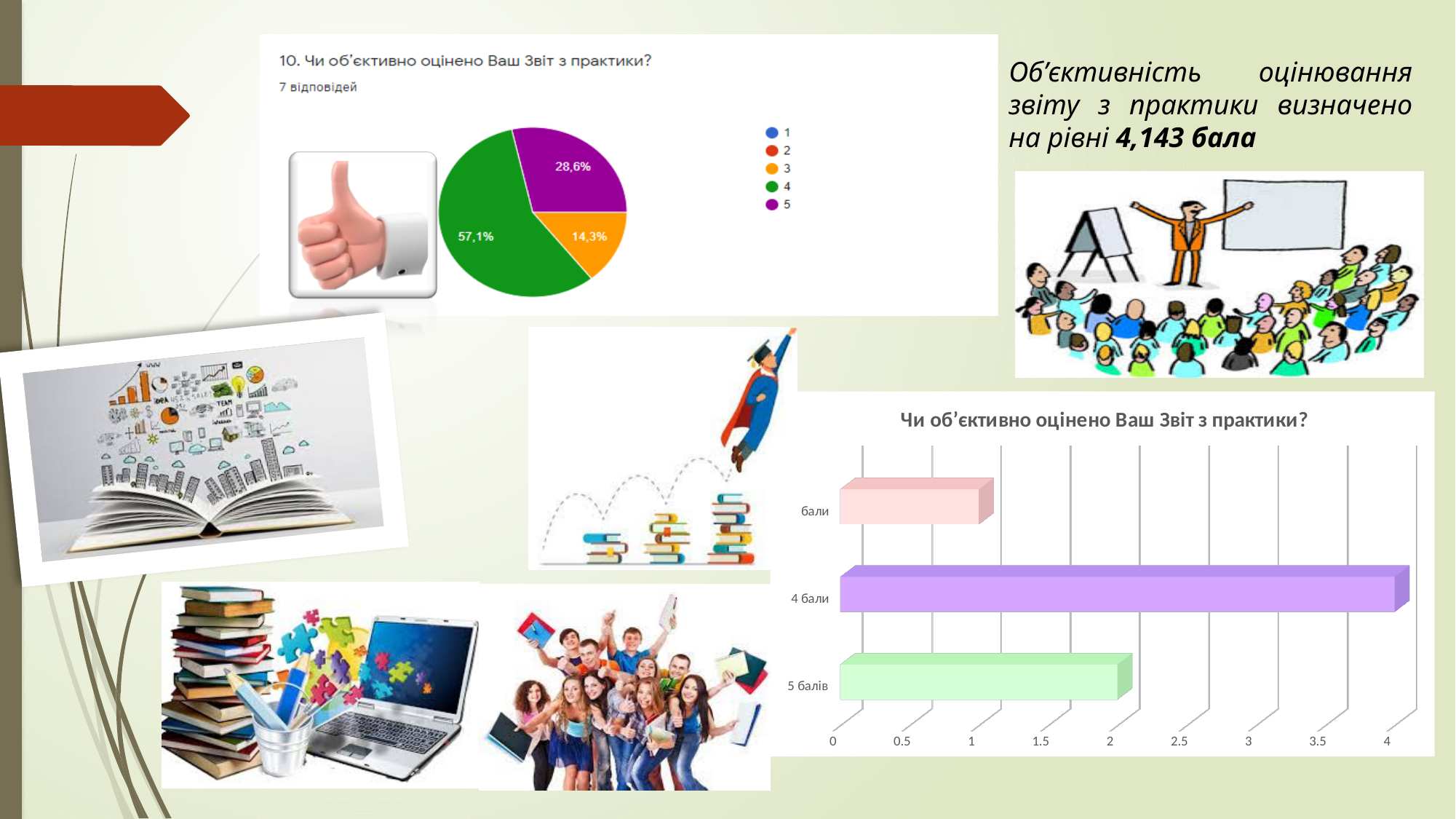
On the pie chart at the top of the slide, which is larger: the slice for 5 or the slice for 3? 5 On the pie chart at the top of the slide, what percentage is shown for the slice labelled 4? 57,1% What kind of chart is the chart at the bottom right titled 'Чи об'єктивно оцінено Ваш Звіт з практики?'? bar chart On the bar chart at the bottom right, which category has the longest bar? 4 бали How many entries does the legend of the pie chart at the top of the slide list? 5 On the bar chart at the bottom right, how many categories are shown? 3 On the pie chart at the top of the slide, which rating has the largest slice? 4 On the pie chart at the top of the slide, what is the difference between the percentages for 4 and 5? 28,5% On the pie chart at the top of the slide, what percentage is shown for the slice labelled 5? 28,6% On the bar chart at the bottom right, is the value for '5 балів' greater or less than 3? less What kind of chart is the chart at the top of the slide with the question '10. Чи об'єктивно оцінено Ваш Звіт з практики?'? pie chart On the pie chart at the top of the slide, what percentage is shown for the slice labelled 3? 14,3%